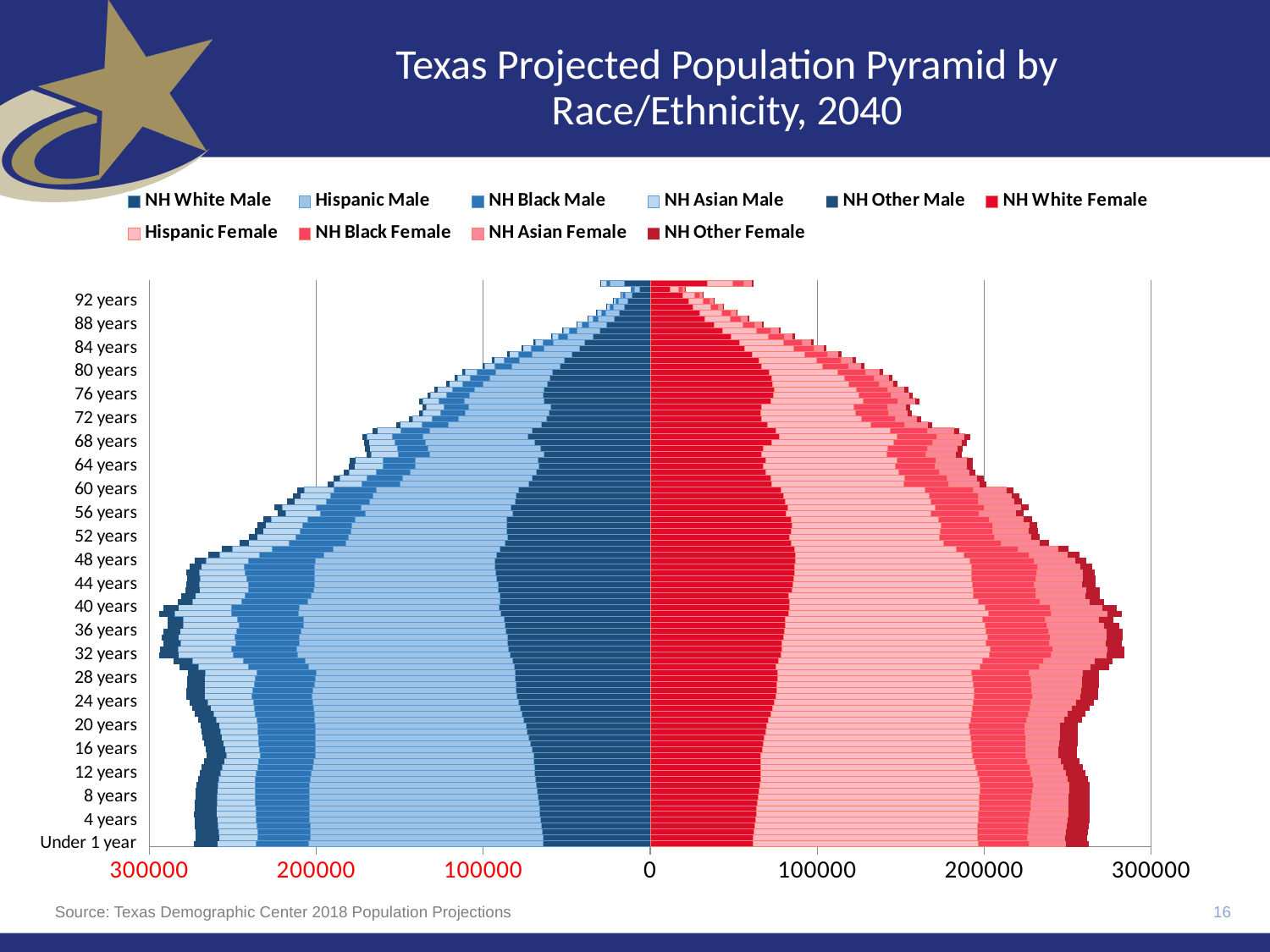
Which side of the chart shows the male population, left or right? left Is the total male bar for Under 1 year greater or less than 200000? greater At 40 years, which segment is longer, NH White Male or Hispanic Male? Hispanic Male Is the total female bar for 60 years greater or less than 100000? greater What is the title of the chart? Texas Projected Population Pyramid by Race/Ethnicity, 2040 Is the total female bar for 92 years greater or less than 100000? less How many series does the legend list? 10 Do the total bar lengths generally increase or decrease moving from the youngest ages at the bottom to the oldest ages at the top? decrease How many age labels are shown on the vertical axis? 24 Which is larger, the total male bar for 4 years or the total male bar for 84 years? 4 years What kind of chart is shown on the slide? bar chart